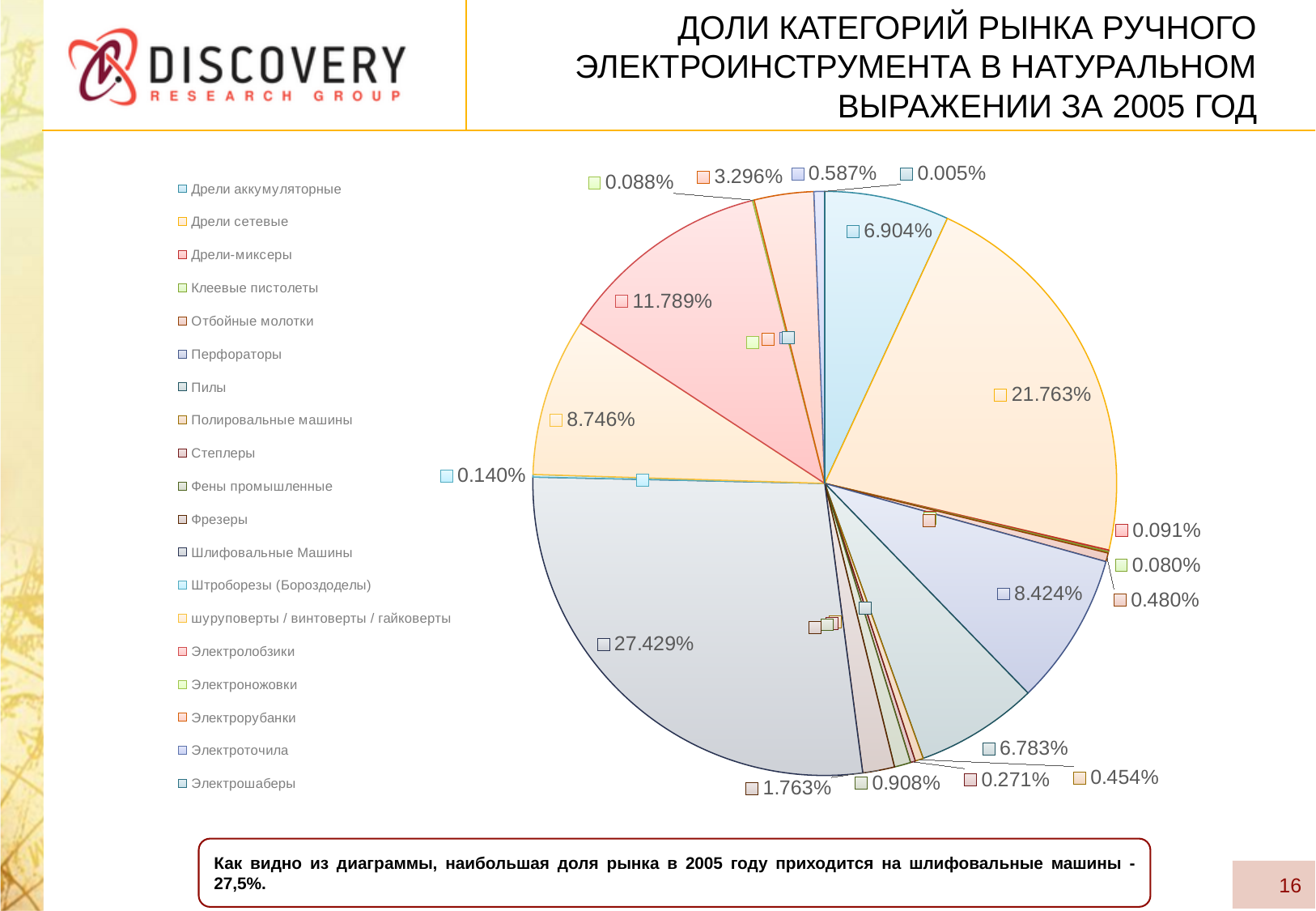
What kind of chart is shown on the slide? pie chart What share does the category Электролобзики have in the pie chart? 11.789% What share does the category Дрели аккумуляторные have in the pie chart? 6.904% What year does the chart title say the market shares refer to? 2005 Which has the larger share, Электролобзики or шуруповерты / винтоверты / гайковерты? Электролобзики What is the difference between the shares of Шлифовальные Машины and Дрели сетевые? 5.666% How many categories does the legend of the pie chart list? 19 What is the largest share shown in the pie chart? 27.429% Which category has the largest share in the pie chart? Шлифовальные Машины What is the smallest share printed on the pie chart? 0.005%